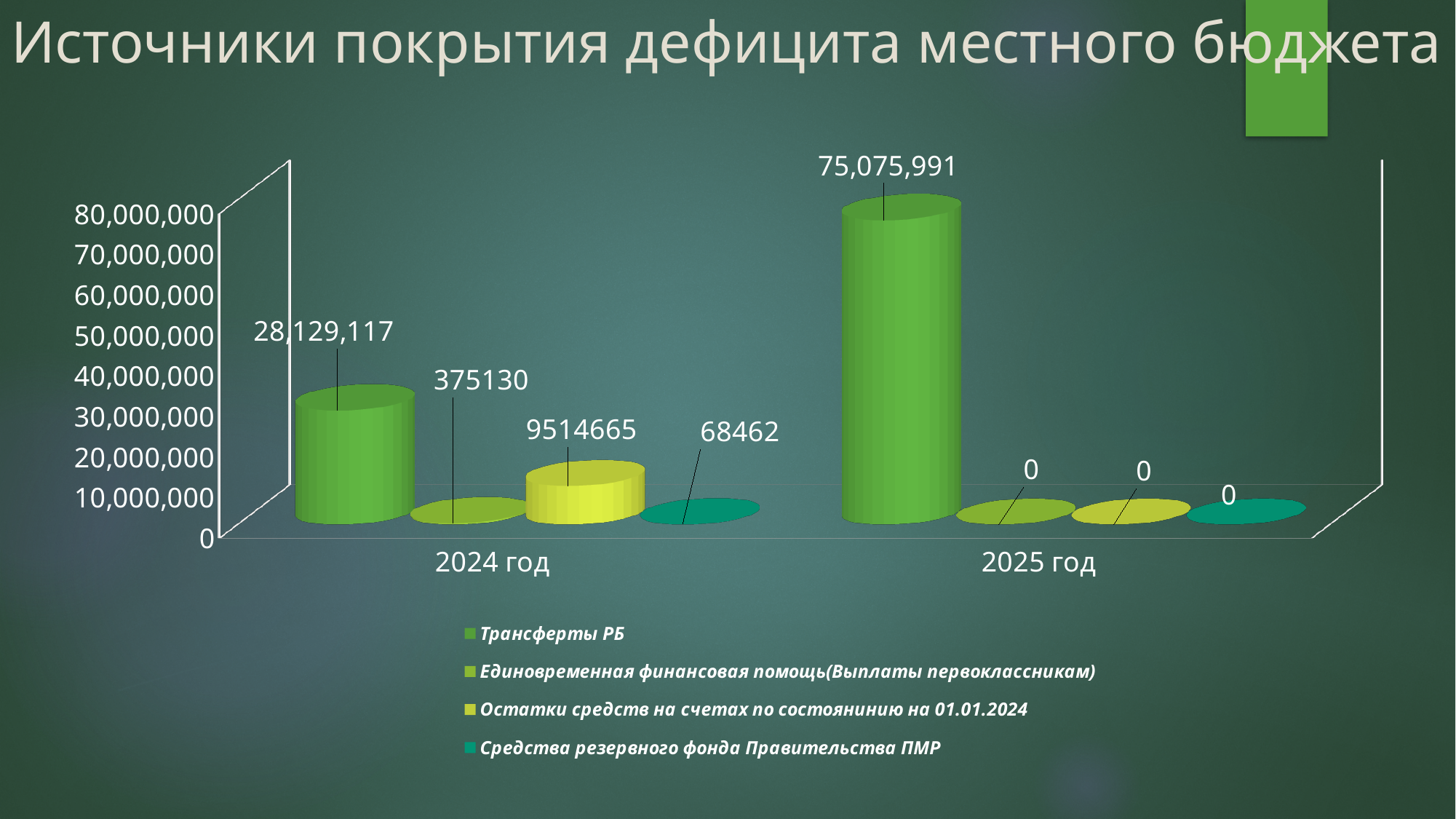
Which series has the lowest value for 2024 год? Средства резервного фонда Правительства ПМР How many categories are shown on the x axis? 2 Which series has the highest value for 2024 год? Трансферты РБ What is the value of Средства резервного фонда Правительства ПМР for 2024 год? 68462 What kind of chart is shown on the slide? Bar chart What is the difference between Трансферты РБ for 2025 год and for 2024 год? 46,946,874 Which is larger: Остатки средств на счетах for 2024 год or Единовременная финансовая помощь for 2024 год? Остатки средств на счетах по состоянинию на 01.01.2024 What is the value of Трансферты РБ for 2024 год? 28,129,117 What is the value of Трансферты РБ for 2025 год? 75,075,991 What is the value of Единовременная финансовая помощь(Выплаты первоклассникам) for 2025 год? 0 How many series does the legend list? 4 What is the value of Остатки средств на счетах по состоянинию на 01.01.2024 for 2024 год? 9514665